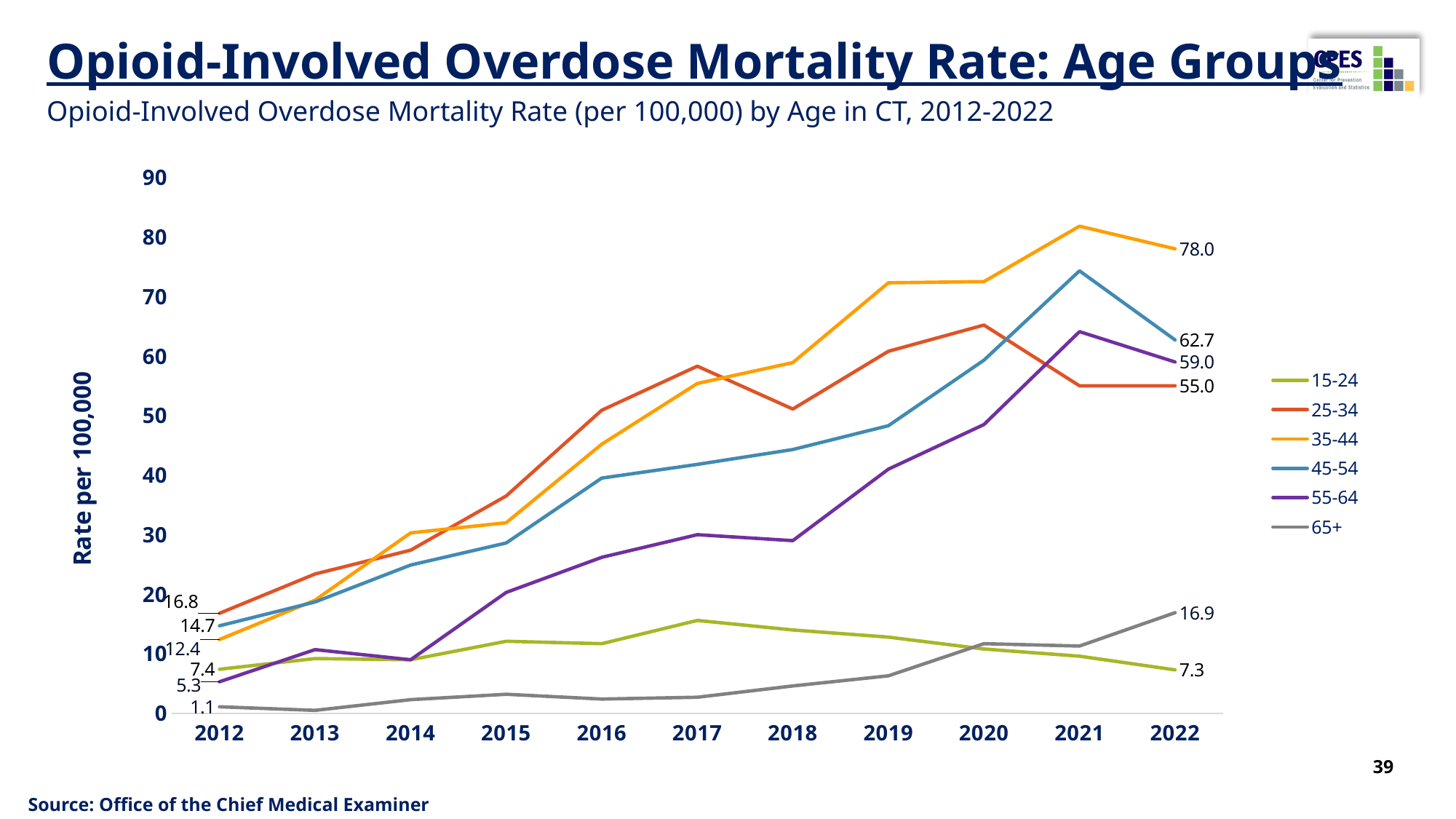
Does the mortality rate for the 65+ age group rise or fall from 2012 to 2022? Rises By how much did the mortality rate for the 35-44 age group increase from 2012 to 2022? 65.6 How many years are shown on the x axis? 11 Which age group has the lowest mortality rate in 2022? 15-24 In 2022, which age group has the higher mortality rate: 45-54 or 55-64? 45-54 What is the opioid-involved overdose mortality rate for the 35-44 age group in 2022? 78.0 Which age group has the highest mortality rate in 2022? 35-44 What is the mortality rate for the 25-34 age group in 2012? 16.8 Is the mortality rate for the 35-44 age group in 2021 greater or less than 80? greater How many age groups does the legend list? 6 What is the mortality rate for the 65+ age group in 2012? 1.1 What type of chart is shown on the slide? Line chart